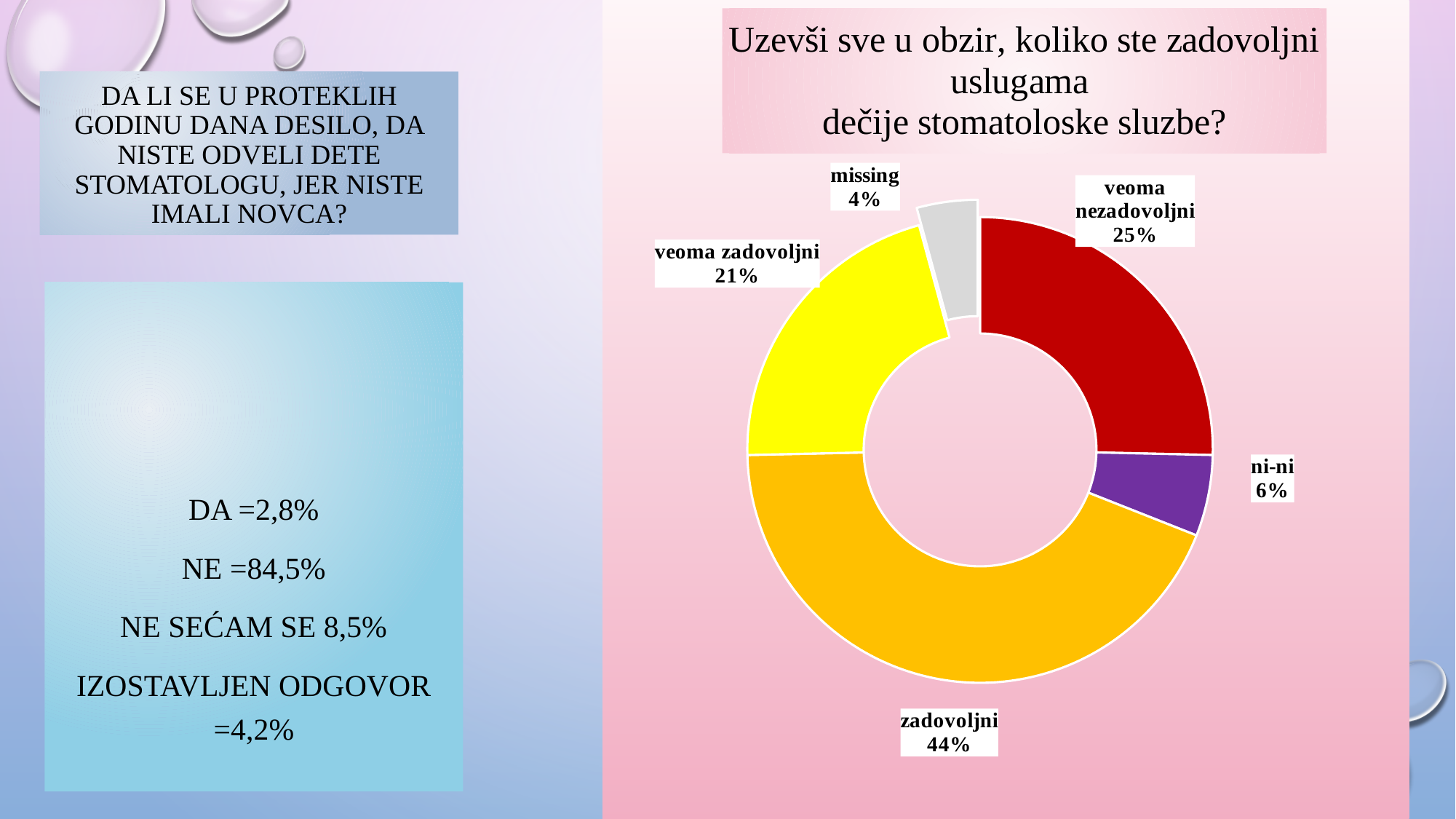
Which category has the smallest share of the chart? missing What percentage is labelled 'ni-ni'? 6% Which is larger, the share for 'veoma nezadovoljni' or the share for 'veoma zadovoljni'? veoma nezadovoljni What percentage of respondents answered 'veoma nezadovoljni'? 25% What is the difference in percentage points between 'zadovoljni' and 'veoma nezadovoljni'? 19 How many categories are shown in the chart? 5 What percentage of respondents answered 'zadovoljni'? 44% What percentage is labelled 'missing'? 4% What colour is the 'zadovoljni' segment of the chart? Orange What percentage of respondents answered 'veoma zadovoljni'? 21% What kind of chart is shown on the slide? Doughnut chart Which category has the largest share of the chart? zadovoljni